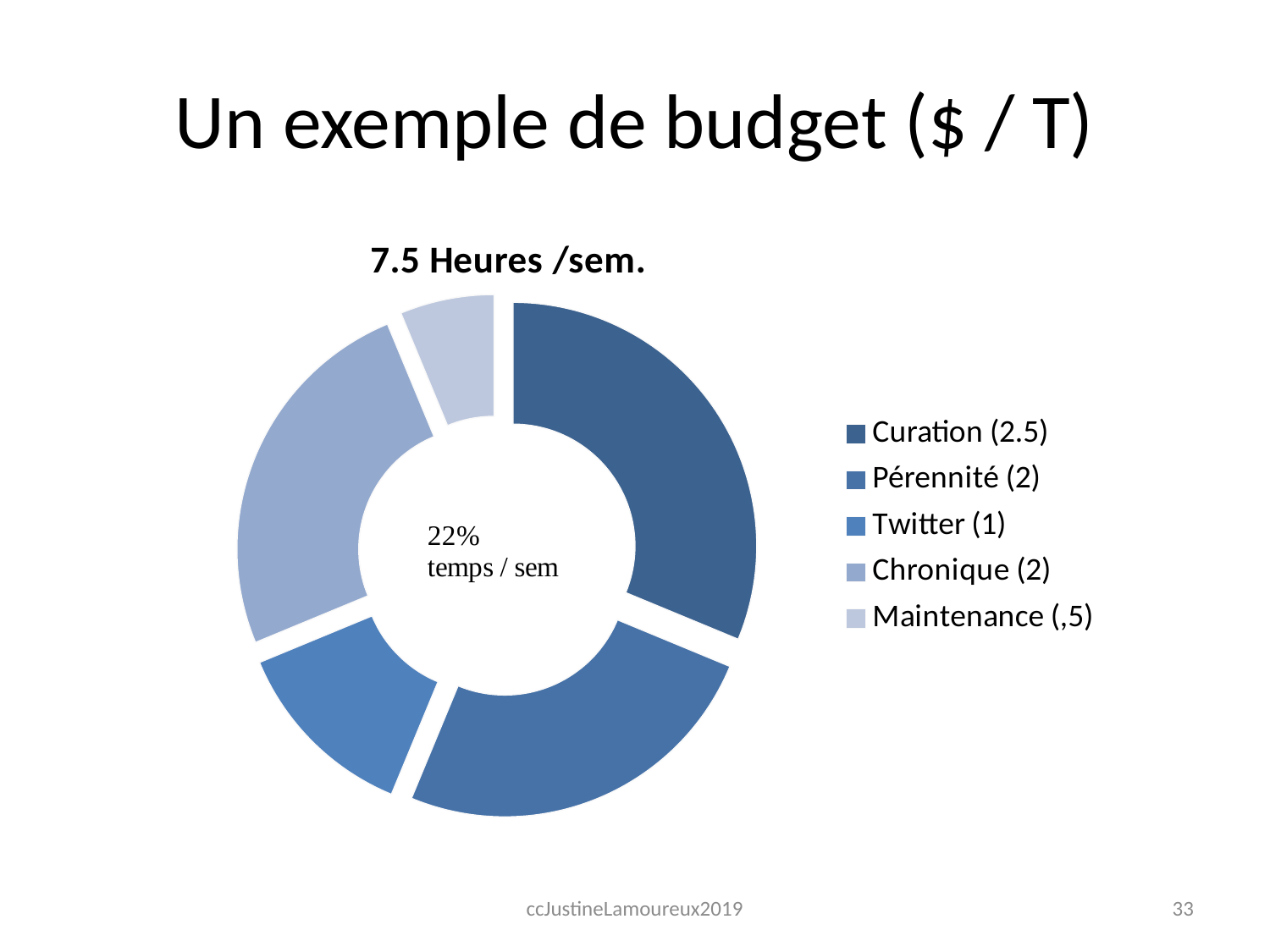
What is the total number of hours per week shown in the chart title? 7.5 Which is larger, the value for Curation or the value for Chronique? Curation Which category has the largest value in the doughnut chart? Curation (2.5) Which category has the smallest value in the doughnut chart? Maintenance (,5) What text appears in the centre of the doughnut chart? 22% temps / sem What is the difference between the values for Curation and Twitter? 1.5 What is the title of the doughnut chart? 7.5 Heures /sem. What value is given for Curation in the legend? 2.5 What value is given for Twitter in the legend? 1 What kind of chart is shown on the slide? Doughnut chart How many categories does the doughnut chart have? 5 What value is given for Maintenance in the legend? ,5